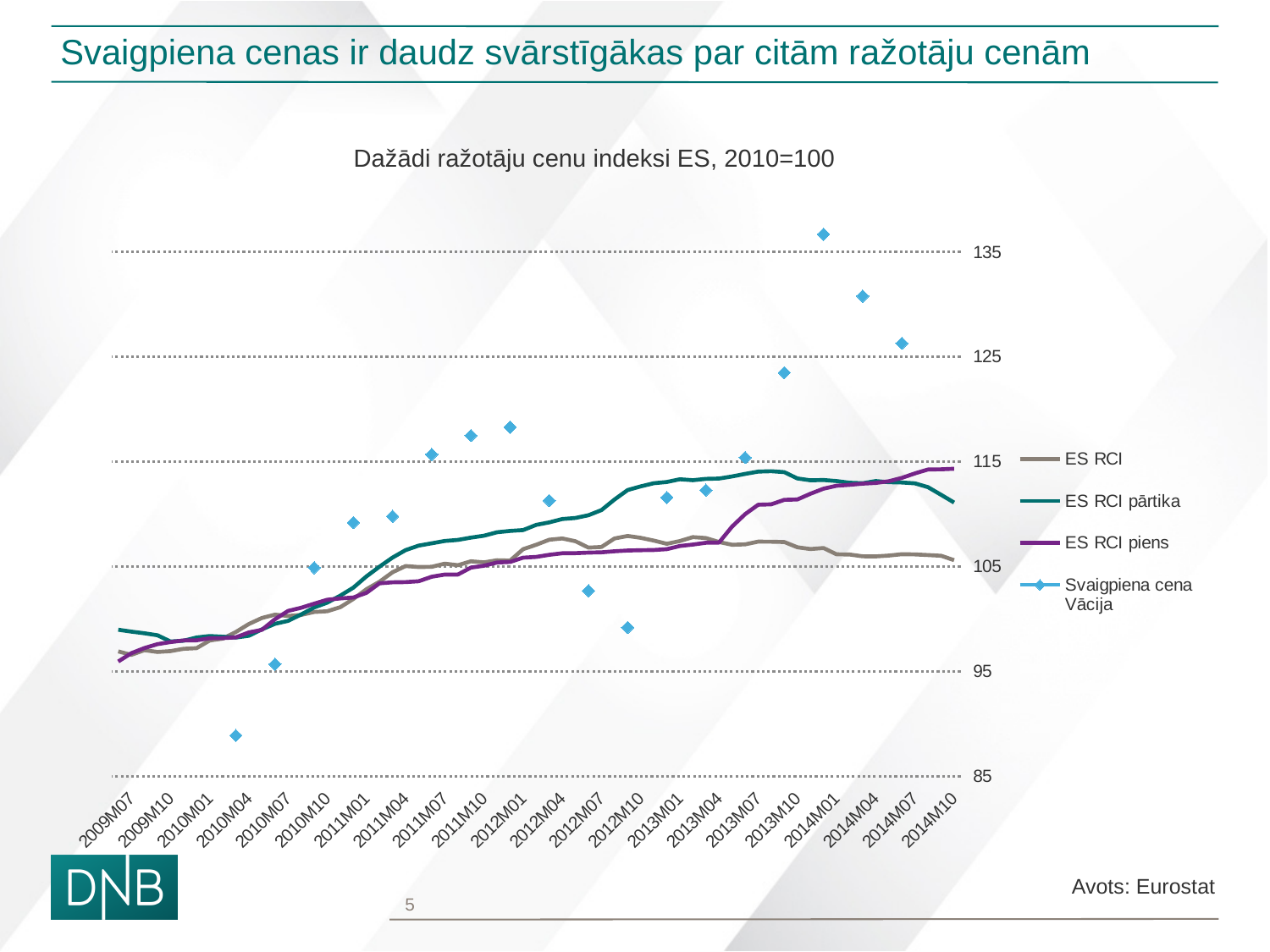
At 2014M10, which is higher: ES RCI piens or ES RCI? ES RCI piens What kind of chart is shown on the slide? Line chart What source is cited for the chart data? Eurostat Is the value for ES RCI at 2009M07 greater or less than 105? less How many series does the legend list? 4 Which series reaches the highest value anywhere on the chart? Svaigpiena cena Vācija What is the title of the chart? Dažādi ražotāju cenu indeksi ES, 2010=100 Is the value for ES RCI pārtika at 2012M01 greater or less than 105? greater Does the ES RCI piens series generally rise or fall from 2009M07 to 2014M10? Rise Which series has the lowest value at 2014M10? ES RCI